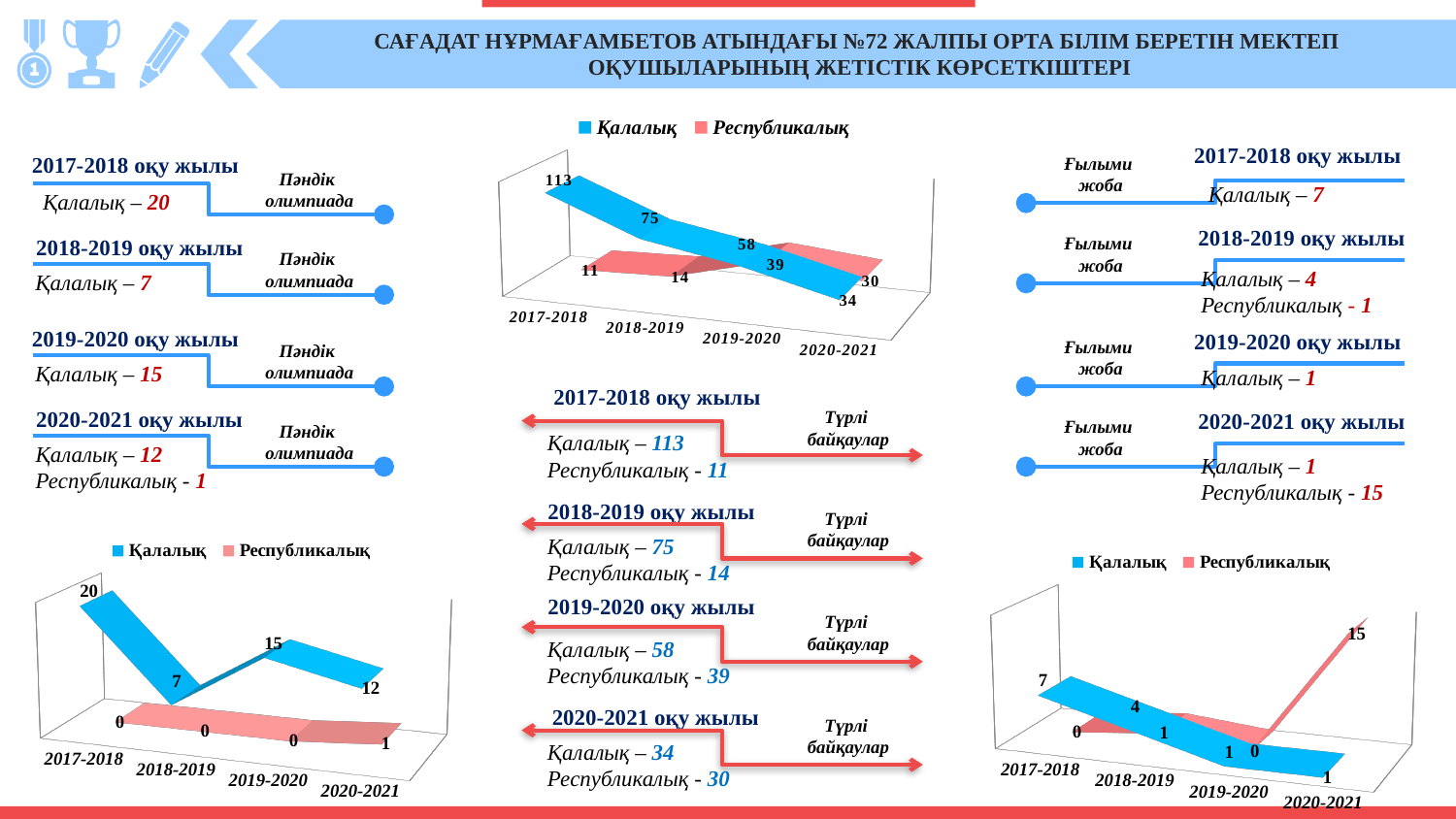
How many categories are shown on the x axis of the top-center chart? 4 In the bottom-right chart, which is larger in 2018-2019: Қалалық or Республикалық? Қалалық In the bottom-left chart, which year has the lowest Қалалық value? 2018-2019 In the bottom-left chart, what is the value for Республикалық in 2020-2021? 1 In the top-center chart, does the Қалалық series rise or fall from 2017-2018 to 2020-2021? fall In the bottom-left chart, what is the value for Қалалық in 2018-2019? 7 In the top-center chart, which year has the highest Қалалық value? 2017-2018 In the bottom-right chart, what is the value for Республикалық in 2020-2021? 15 In the top-center chart, what is the value for Қалалық in 2017-2018? 113 In the top-center chart, what is the value for Республикалық in 2019-2020? 39 How many series does the legend of the bottom-right chart list? 2 In the top-center chart, what is the difference between Қалалық and Республикалық in 2020-2021? 4